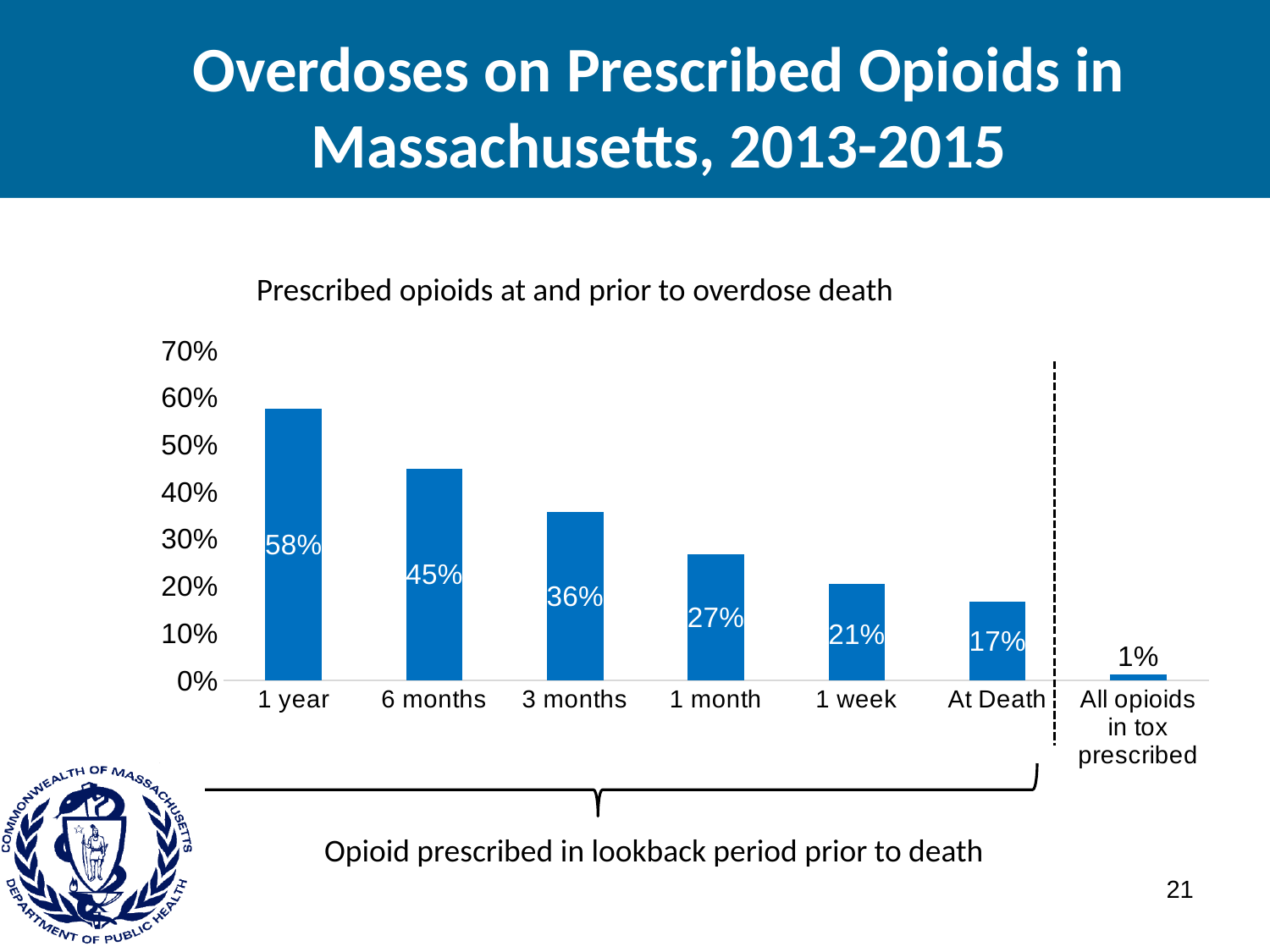
What is the value for All opioids in tox prescribed? 1% What is the value for 3 months? 36% What is the value for 1 year? 58% What is the title of the chart? Prescribed opioids at and prior to overdose death What kind of chart is shown on the slide? bar chart Is the value for 6 months greater or less than 40%? greater Which is larger, the value for 1 week or the value for At Death? 1 week Which category has the lowest value? All opioids in tox prescribed Which category has the highest value? 1 year What is the difference between the values for 6 months and 1 month? 18% How many categories are shown on the x axis? 7 What is the value for At Death? 17%